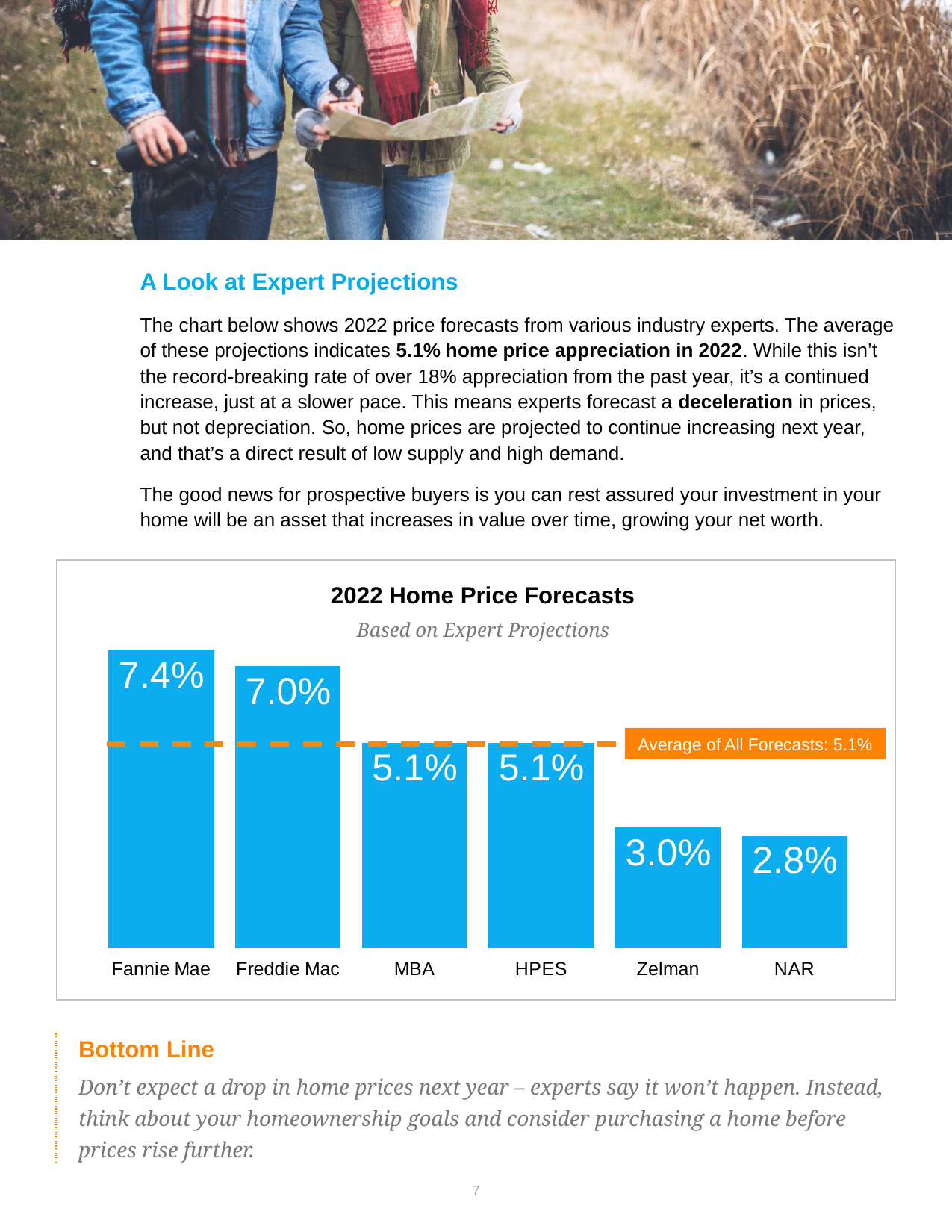
Which is larger, the forecast for MBA or the forecast for Zelman? MBA What is the difference between the Fannie Mae and Freddie Mac forecasts? 0.4% How many forecasters are shown in the chart? 6 What is the 2022 home price forecast for NAR? 2.8% What is the 2022 home price forecast for Zelman? 3.0% What is the difference between the Freddie Mac and NAR forecasts? 4.2% Which forecaster has the highest 2022 home price forecast? Fannie Mae What kind of chart is shown on the slide? Bar chart What is the subtitle of the chart? Based on Expert Projections Which forecaster has the lowest 2022 home price forecast? NAR What is the 2022 home price forecast for Fannie Mae? 7.4% What is the average of all forecasts shown by the dashed line? 5.1%